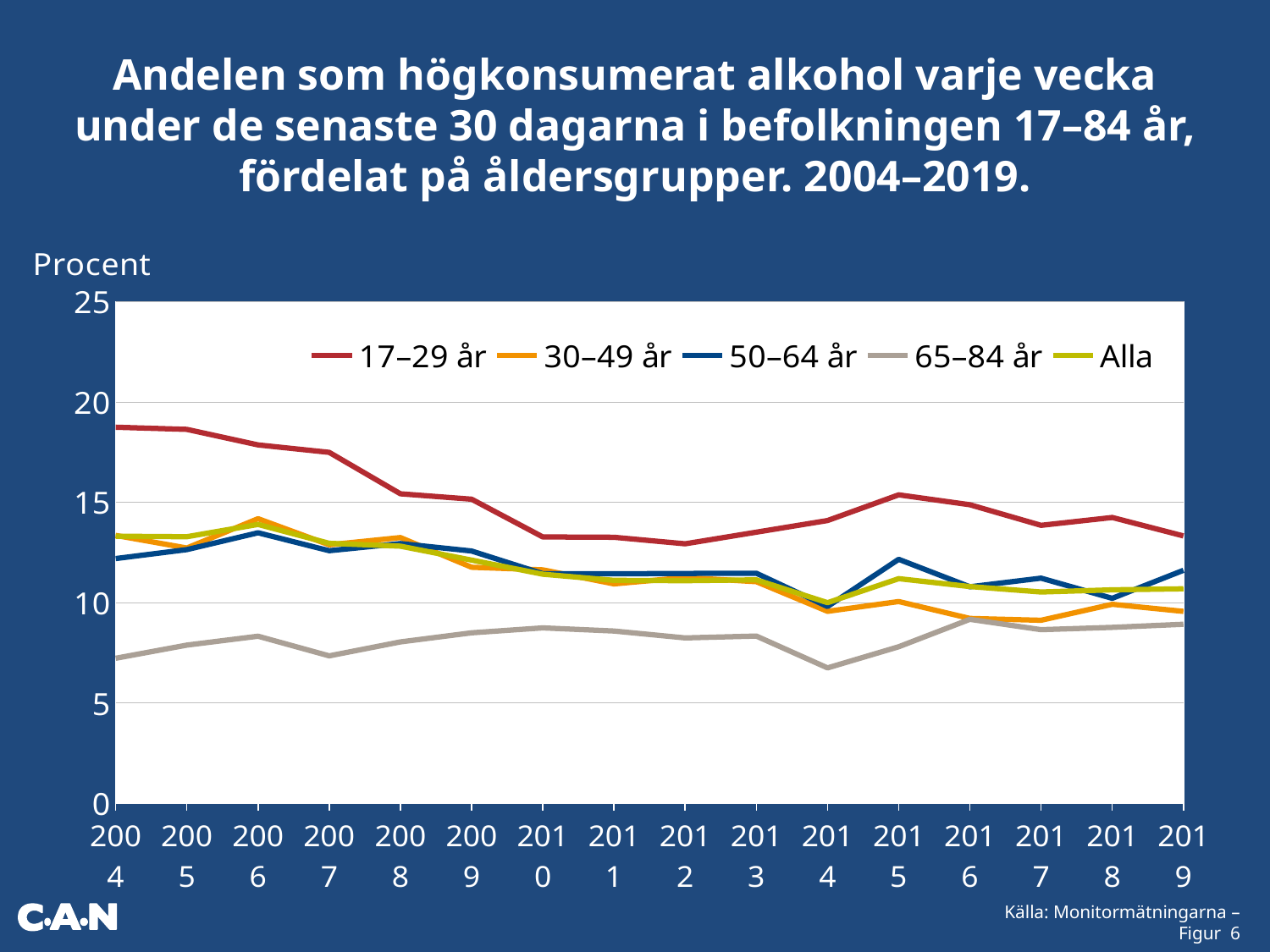
How many years are plotted along the x axis? 16 What source is cited below the chart? Källa: Monitormätningarna – Figur 6 How many series does the legend list? 5 Which age group has the highest value in 2004? 17–29 år Which is larger in 2008, the value for 17–29 år or the value for 50–64 år? 17–29 år Does the value for 17–29 år rise or fall from 2004 to 2010? fall Is the value for 17–29 år in 2019 greater or less than 10? greater Which age group has the lowest value in 2004? 65–84 år Is the value for 65–84 år in 2014 greater or less than 10? less What label is shown on the vertical axis? Procent Is the value for 17–29 år in 2004 greater or less than 15? greater What kind of chart is shown on the slide? line chart